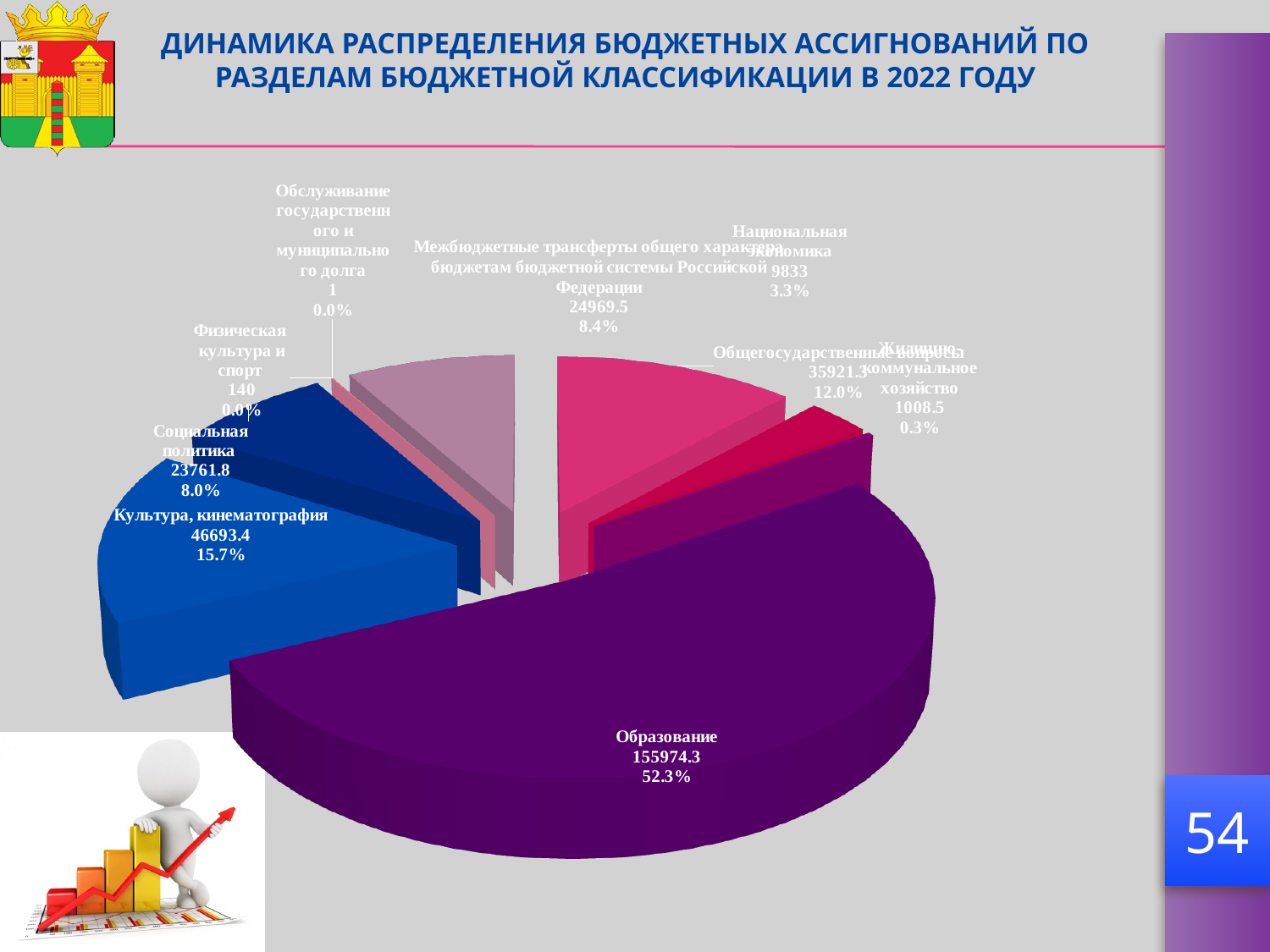
What value is shown for Жилищно-коммунальное хозяйство? 1008.5 What kind of chart is shown on the slide? pie chart Which is larger, the value for Межбюджетные трансферты общего характера or the value for Национальная экономика? Межбюджетные трансферты общего характера How many categories are shown in the pie chart? 9 What share of the pie does Общегосударственные вопросы represent? 12.0% What value is shown for Образование? 155974.3 What share of the pie does Образование represent? 52.3% Which category has the smallest value in the pie chart? Обслуживание государственного и муниципального долга What value is shown for Культура, кинематография? 46693.4 Which category has the largest value in the pie chart? Образование What is the difference between the values for Культура, кинематография and Социальная политика? 22931.6 What year does the chart title refer to? 2022